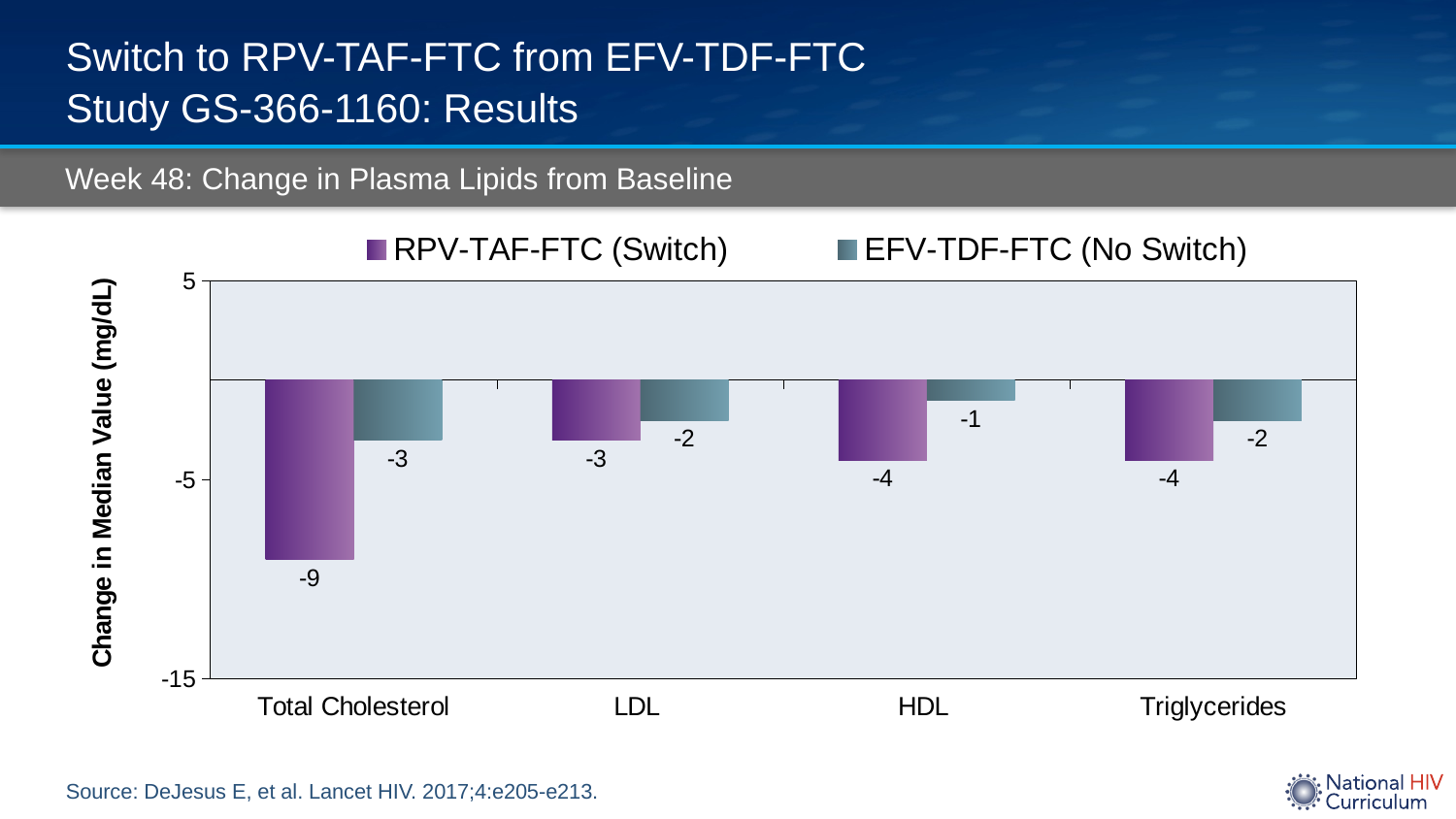
What is the change in median value for Total Cholesterol in the RPV-TAF-FTC (Switch) group? -9 How many lipid categories are shown on the x axis? 4 What is the change in median value for HDL in the EFV-TDF-FTC (No Switch) group? -1 Which lipid category shows the largest decrease for the RPV-TAF-FTC (Switch) group? Total Cholesterol What kind of chart is shown on the slide? Bar chart Which group shows a larger decrease in HDL, RPV-TAF-FTC (Switch) or EFV-TDF-FTC (No Switch)? RPV-TAF-FTC (Switch) What is the difference between the RPV-TAF-FTC (Switch) and EFV-TDF-FTC (No Switch) values for Total Cholesterol? 6 Which lipid category shows the smallest decrease for the EFV-TDF-FTC (No Switch) group? HDL How many series does the legend list? 2 What is the change in median value for Triglycerides in the RPV-TAF-FTC (Switch) group? -4 What is the change in median value for LDL in the EFV-TDF-FTC (No Switch) group? -2 What is the label of the y axis? Change in Median Value (mg/dL)